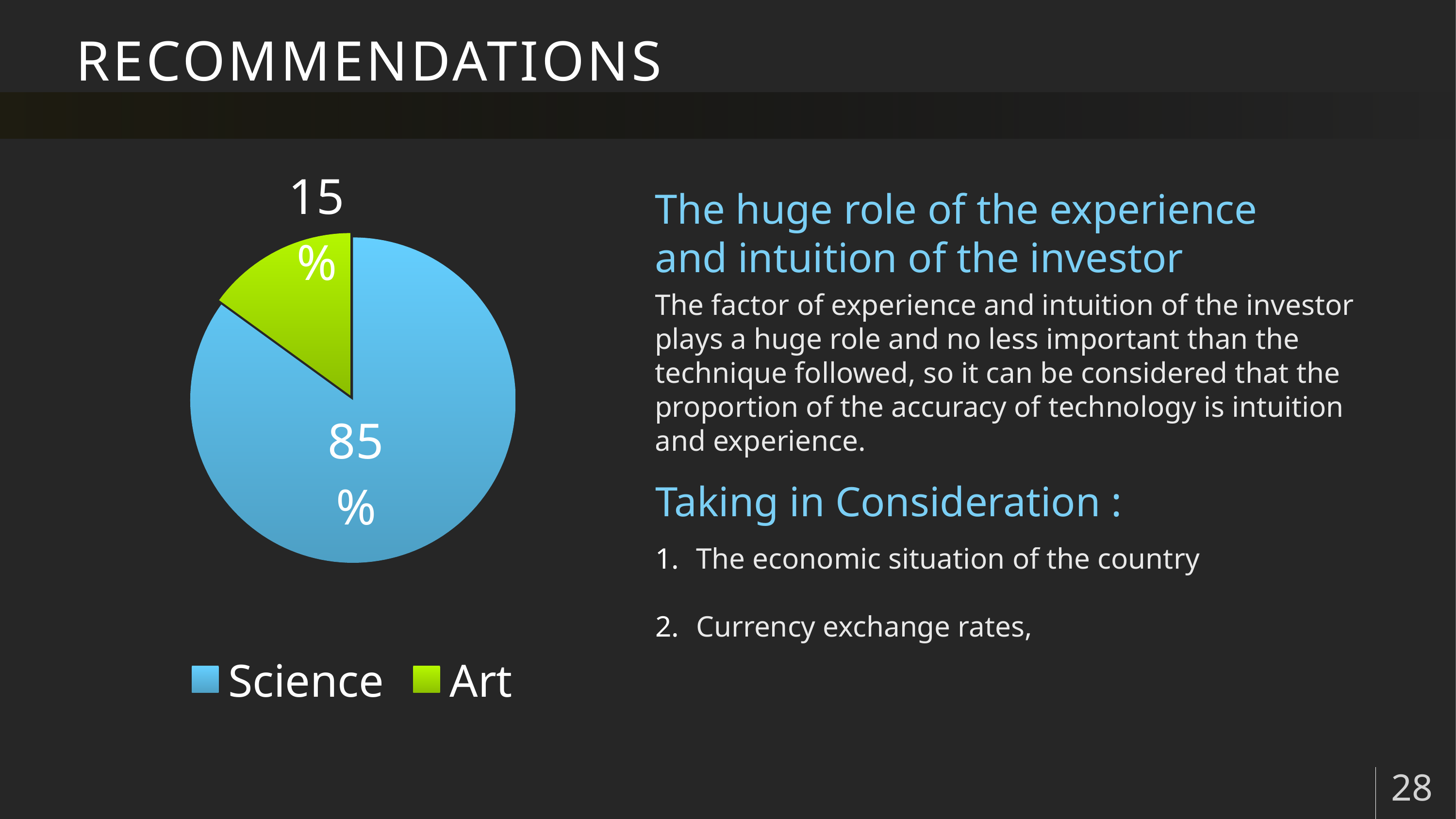
Which slice of the pie chart is the largest? Science Which is larger in the pie chart, Science or Art? Science What is the difference between the Science and Art values in the pie chart? 70% What kind of chart is shown on the slide? pie chart How many slices does the pie chart have? 2 What is the value shown for Science in the pie chart? 85% What is the value shown for Art in the pie chart? 15% What colour is the Science slice in the pie chart? blue Which slice of the pie chart is the smallest? Art What colour is the Art slice in the pie chart? green What share of the pie does the Art slice represent? 15% How many entries does the pie chart legend list? 2